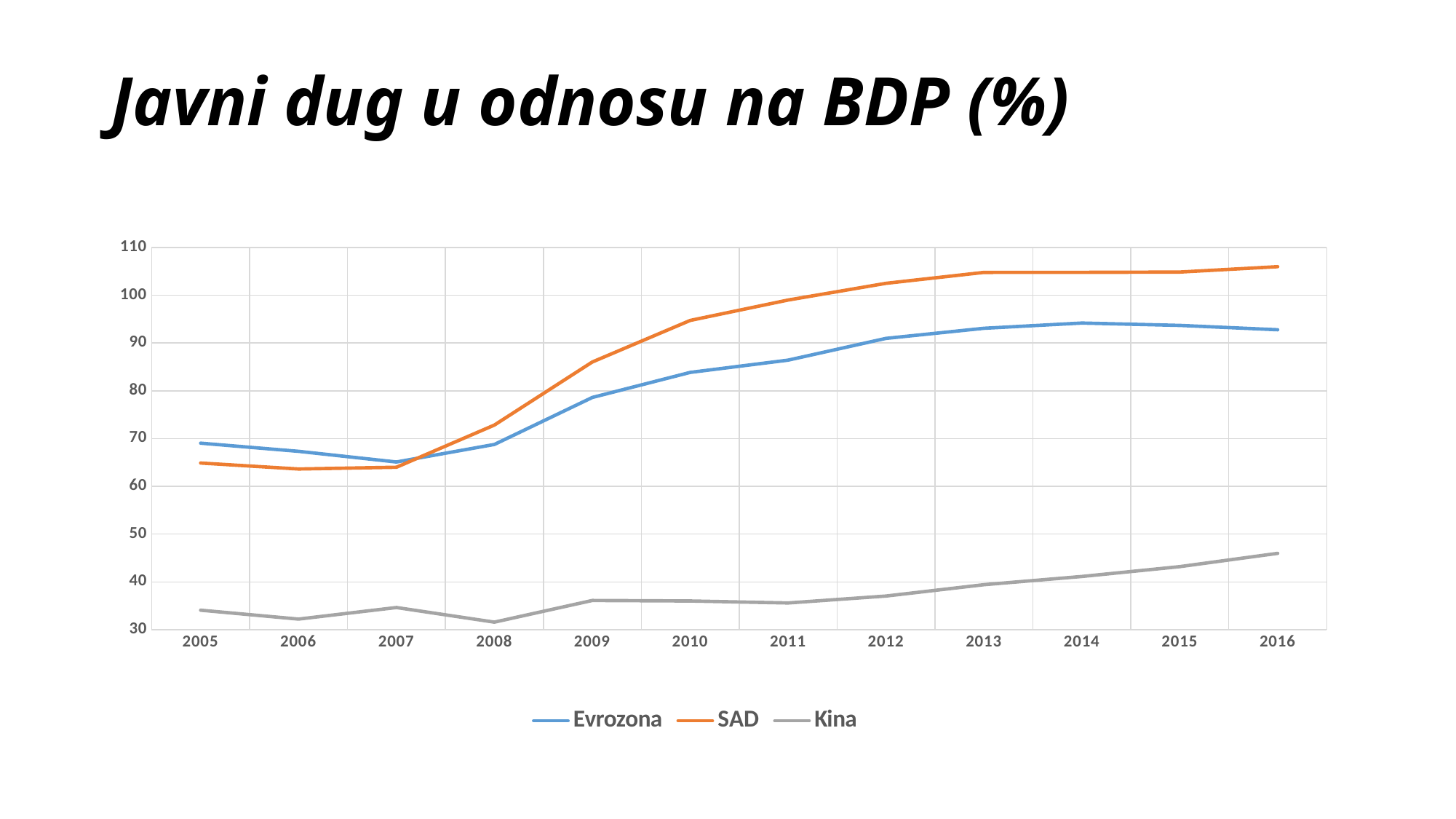
How many series does the legend list? 3 Which series has the lowest values across all years shown? Kina In 2005, which is larger: the value for Evrozona or the value for SAD? Evrozona Is the value for Evrozona in 2010 greater or less than 80? greater Does the value for Kina rise or fall from 2009 to 2016? rise Which series has the highest value in 2016? SAD In 2012, which is larger: the value for Kina or the value for Evrozona? Evrozona Is the value for SAD in 2016 greater or less than 100? greater What kind of chart is shown on the slide? line chart What is the title of the slide? Javni dug u odnosu na BDP (%) How many years are plotted along the x axis? 12 Is the value for Kina in 2016 greater or less than 50? less